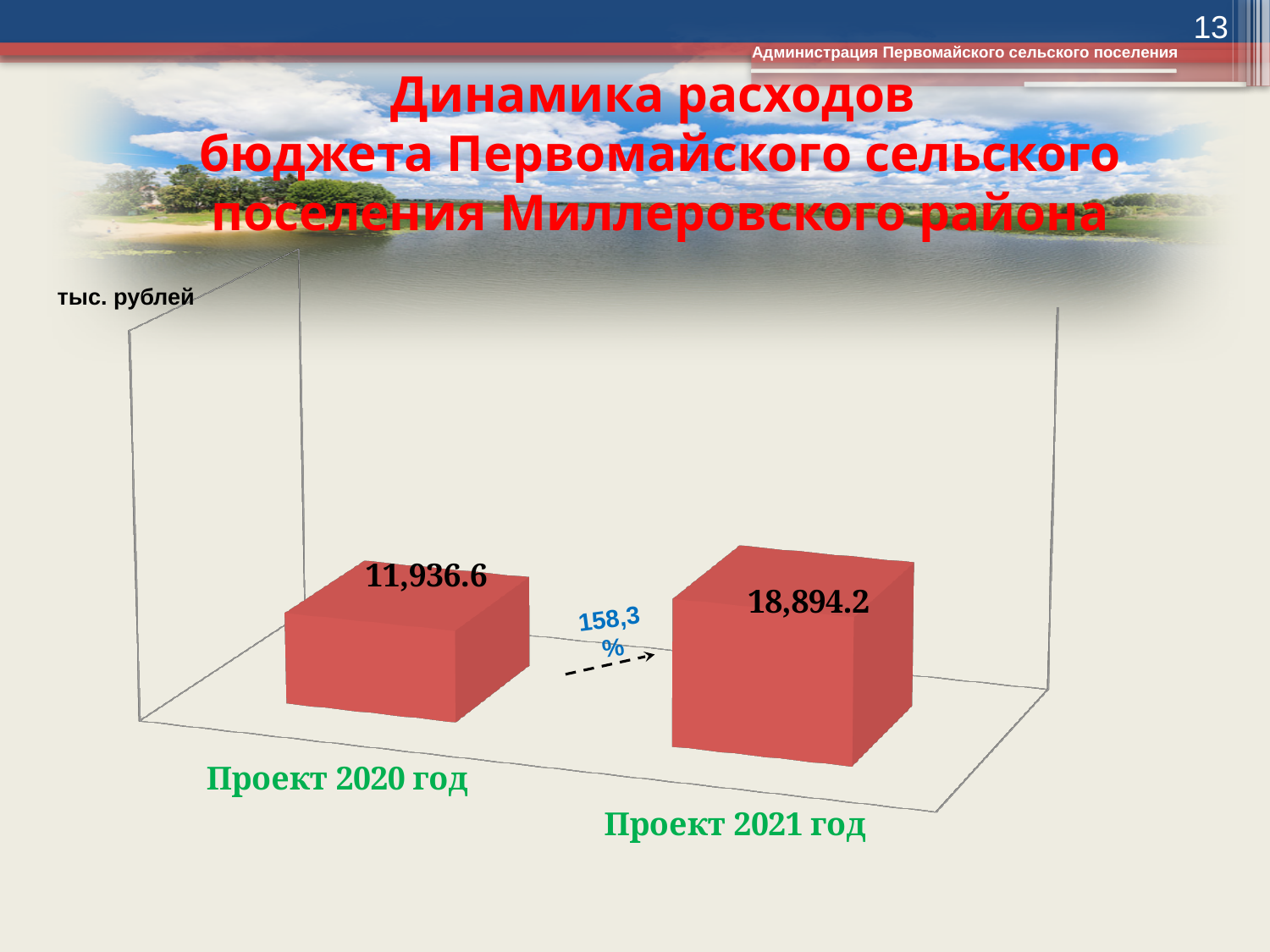
What is the value for Проект 2020 год? 11,936.6 What percentage is shown on the arrow between the two bars? 158,3 % How many categories are shown in the chart? 2 Do the values rise or fall from Проект 2020 год to Проект 2021 год? rise Which is larger, the value for Проект 2020 год or Проект 2021 год? Проект 2021 год What is the difference between the values for Проект 2021 год and Проект 2020 год? 6,957.6 What unit of measurement is indicated on the chart? тыс. рублей What kind of chart is shown on the slide? bar chart Which category has the highest value? Проект 2021 год Which category has the lowest value? Проект 2020 год What is the value for Проект 2021 год? 18,894.2